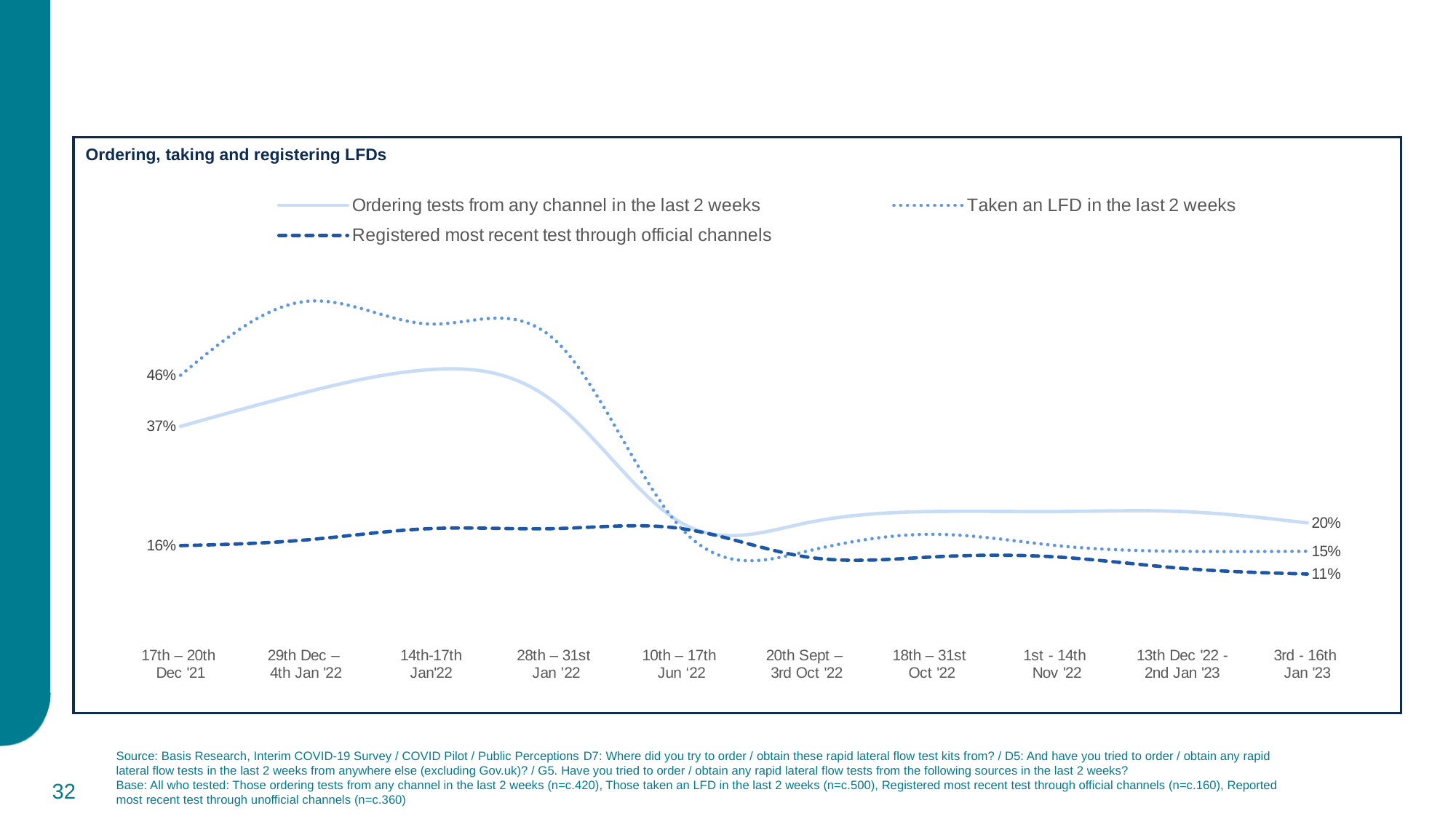
What is the value for 'Taken an LFD in the last 2 weeks' at 17th – 20th Dec '21? 46% At 3rd - 16th Jan '23, which is larger: 'Ordering tests from any channel in the last 2 weeks' or 'Taken an LFD in the last 2 weeks'? Ordering tests from any channel in the last 2 weeks Does the 'Taken an LFD in the last 2 weeks' series rise or fall overall from the first period to the last? Fall Which series has the lowest value at 3rd - 16th Jan '23? Registered most recent test through official channels What is the value for 'Registered most recent test through official channels' at 3rd - 16th Jan '23? 11% How many series does the legend list? 3 What is the value for 'Ordering tests from any channel in the last 2 weeks' at 17th – 20th Dec '21? 37% Which series has the highest value at 17th – 20th Dec '21? Taken an LFD in the last 2 weeks What kind of chart is shown on the slide? Line chart How many time periods are shown on the x axis? 10 What is the value for 'Ordering tests from any channel in the last 2 weeks' at 3rd - 16th Jan '23? 20% By how many percentage points did 'Taken an LFD in the last 2 weeks' fall from 17th – 20th Dec '21 to 3rd - 16th Jan '23? 31 percentage points